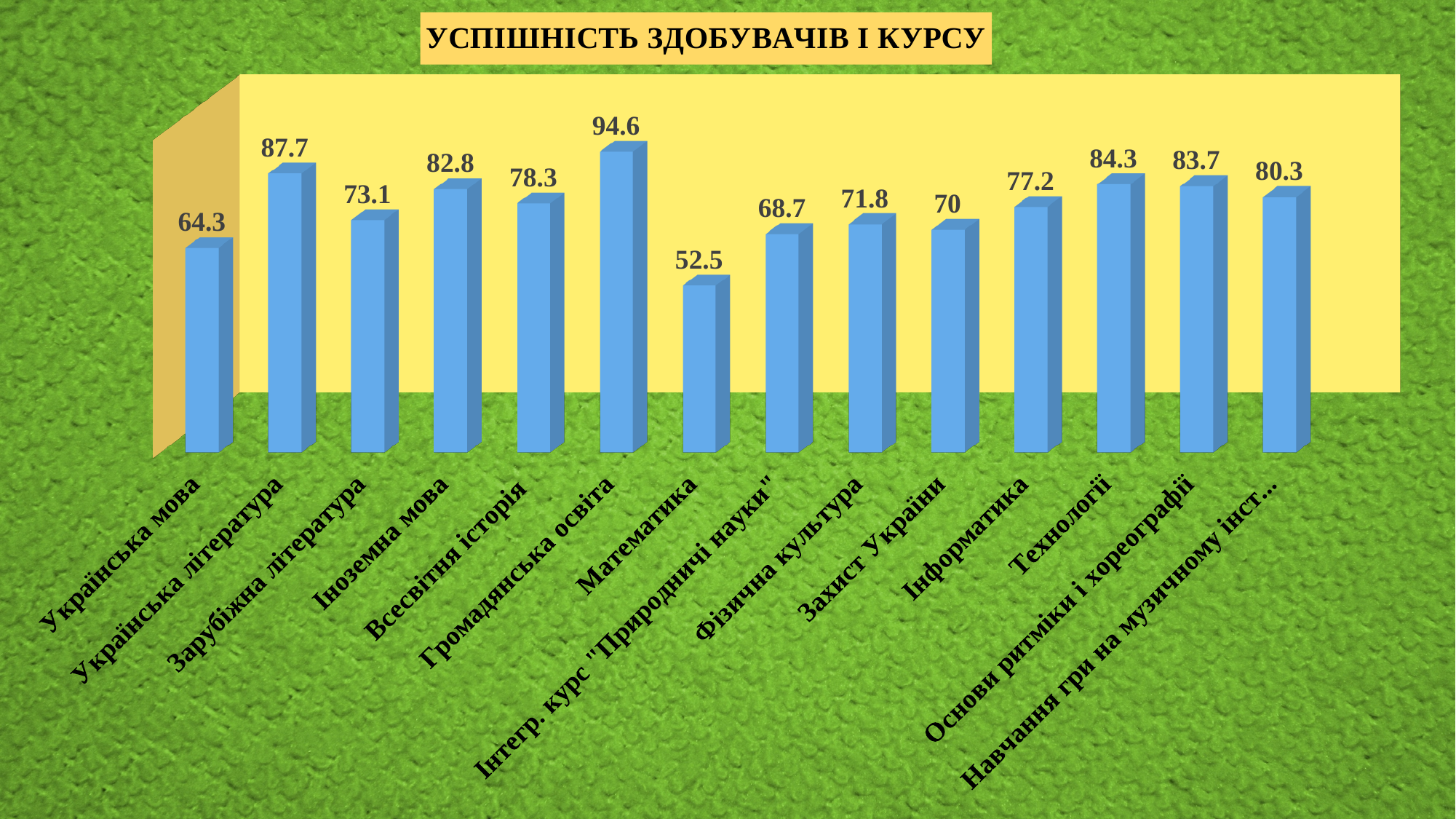
What is the value for Технології? 84.3 Which is larger, the value for Іноземна мова or the value for Всесвітня історія? Іноземна мова What kind of chart is shown on the slide? bar chart Which category has the lowest value? Математика What is the value for Математика? 52.5 What is the difference between the values for Українська література and Українська мова? 23.4 What is the title of the chart? УСПІШНІСТЬ ЗДОБУВАЧІВ І КУРСУ Which category has the highest value? Громадянська освіта What is the value for Захист України? 70 How many categories are plotted in the chart? 14 What is the difference between the values for Громадянська освіта and Математика? 42.1 What is the value for Громадянська освіта? 94.6